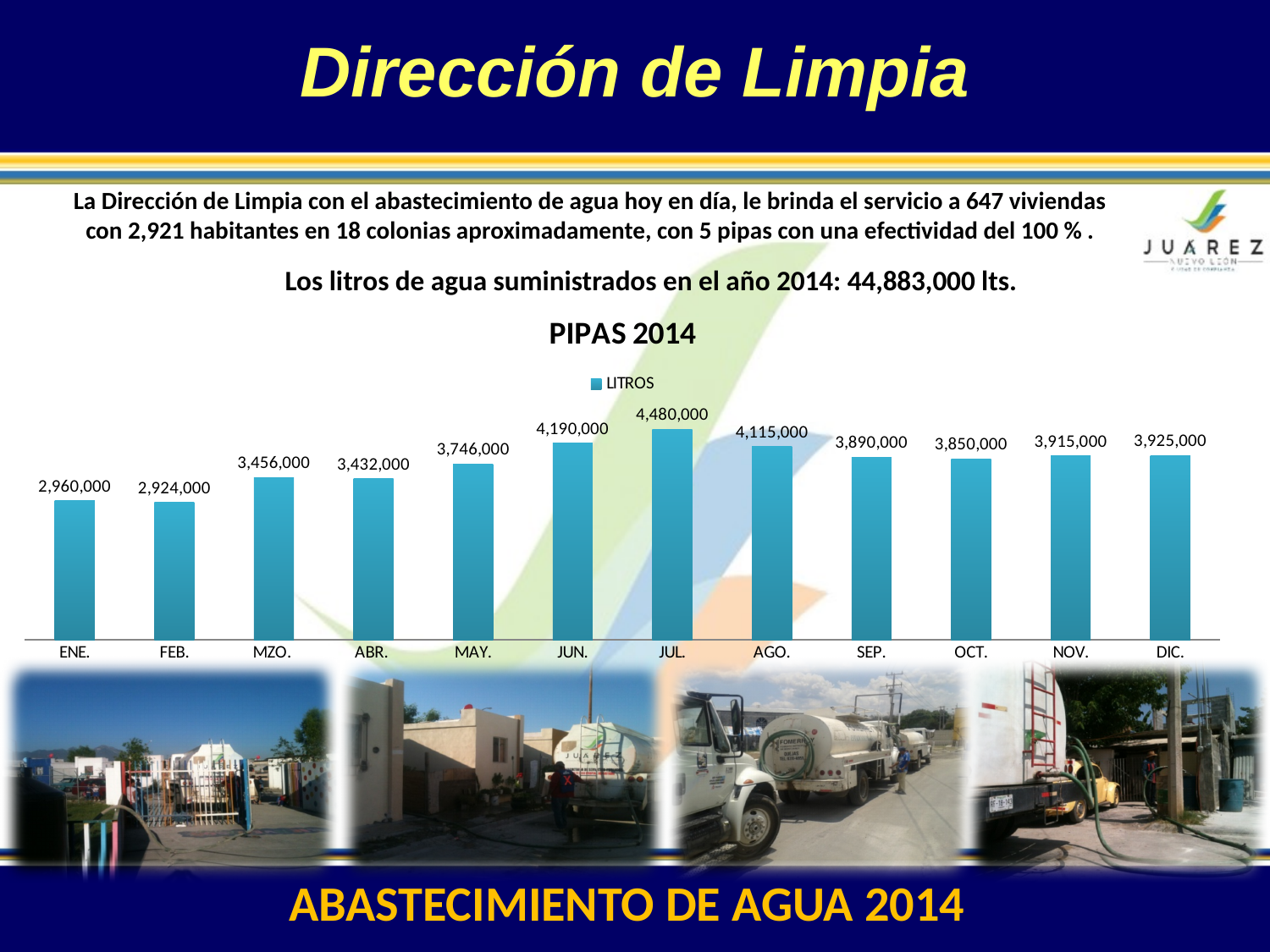
How many months are shown on the x axis of the PIPAS 2014 chart? 12 What is the value for OCT. in the PIPAS 2014 chart? 3,850,000 What is the value for JUL. in the PIPAS 2014 chart? 4,480,000 Which month has the lowest value in the PIPAS 2014 chart? FEB. What kind of chart is the PIPAS 2014 chart? Bar chart Which is larger in the PIPAS 2014 chart, the value for AGO. or the value for SEP.? AGO. What is the name of the series shown in the legend of the PIPAS 2014 chart? LITROS Which month has the highest value in the PIPAS 2014 chart? JUL. What is the difference between the values for JUL. and ENE. in the PIPAS 2014 chart? 1,520,000 What is the difference between the values for JUN. and MAY. in the PIPAS 2014 chart? 444,000 How many series does the legend of the PIPAS 2014 chart list? 1 What is the value for ENE. in the PIPAS 2014 chart? 2,960,000